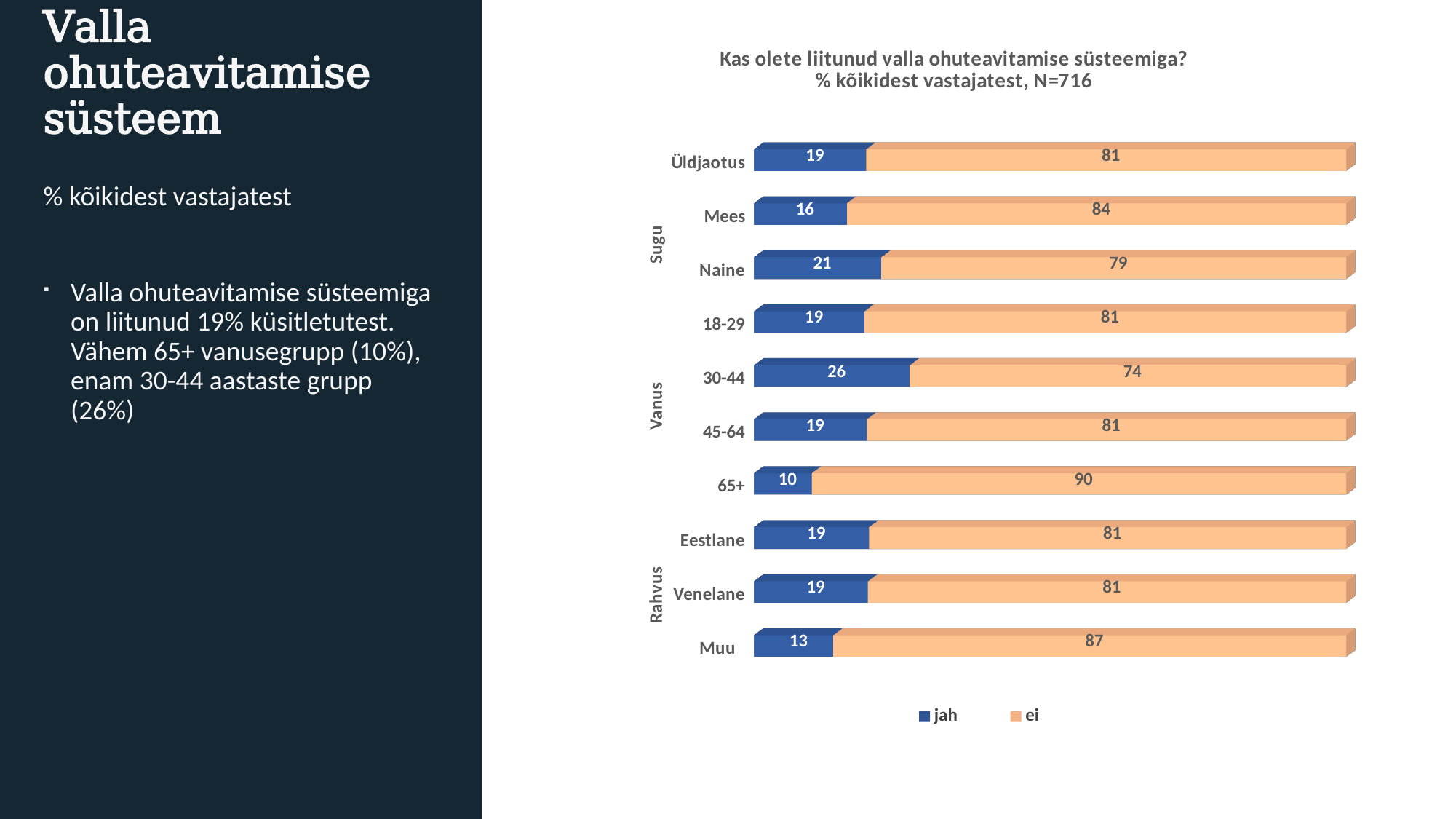
What is the total of the stacked bar for Üldjaotus? 100 What is the 'jah' value for the 30-44 age group? 26 What kind of chart is shown on the slide? Stacked bar chart Which has a larger 'ei' value, 65+ or Muu? 65+ What is the 'ei' value for Mees? 84 How many categories are shown on the chart? 10 What is the 'jah' value for Muu? 13 What is the difference between the 'jah' values for Naine and Mees? 5 What is the N value stated in the chart title? 716 How many series does the legend list? 2 Which category has the lowest 'jah' value? 65+ Which category has the highest 'jah' value? 30-44